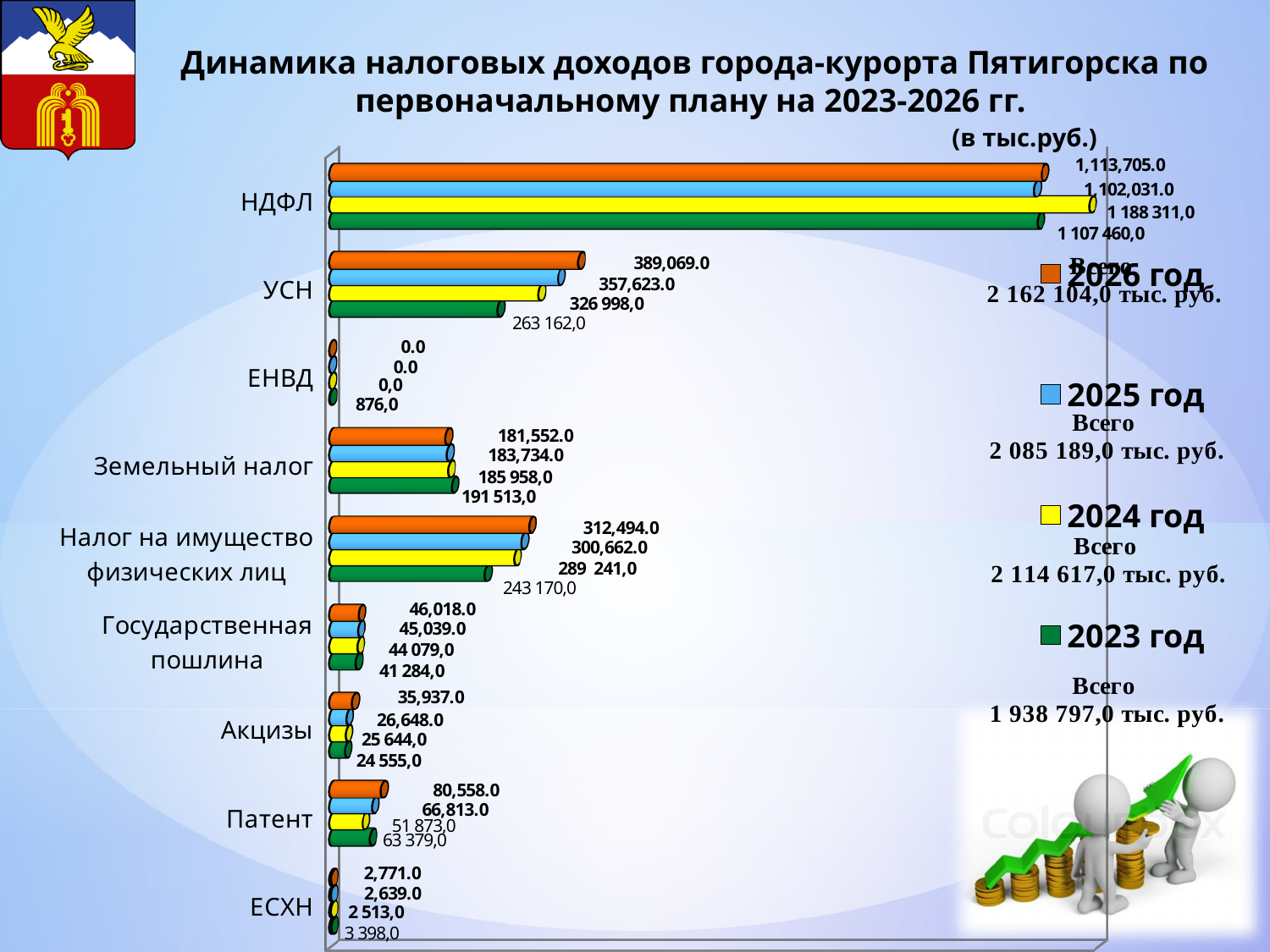
For Акцизы, which is larger: the 2026 год value or the 2025 год value? 2026 год For Патент, which is larger: the 2024 год value or the 2023 год value? 2023 год How many tax categories are shown on the chart? 9 What is the value for УСН in the 2023 год series? 263 162,0 What is the value for ЕНВД in the 2023 год series? 876,0 Which category has the highest value in the 2026 год series? НДФЛ Which category has the lowest value in the 2024 год series? ЕНВД How many series does the legend list? 4 What is the value for Патент in the 2025 год series? 66,813.0 What kind of chart is shown on the slide? Bar chart What is the difference between the 2026 год and 2025 год values for УСН? 31,446.0 What is the value for НДФЛ in the 2026 год series? 1,113,705.0